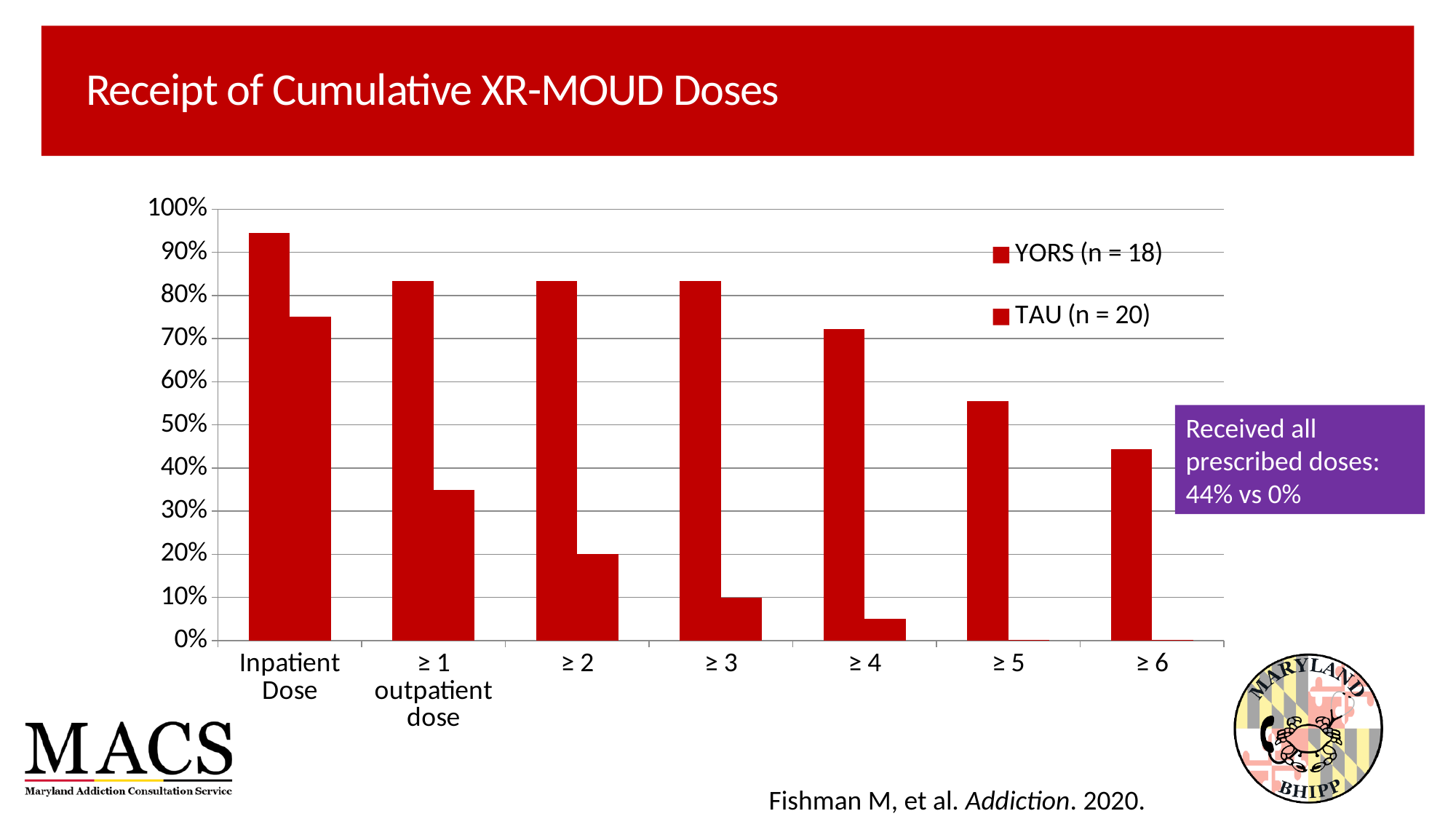
Which category has the lowest YORS (n = 18) value? ≥ 6 For the ≥ 4 category, which series has the larger value, YORS (n = 18) or TAU (n = 20)? YORS (n = 18) How many categories are shown along the x axis? 7 Is the YORS (n = 18) value for Inpatient Dose greater or less than 90%? greater Which category has the highest YORS (n = 18) value? Inpatient Dose Is the TAU (n = 20) value for ≥ 1 outpatient dose greater or less than 40%? less Do the TAU (n = 20) values rise or fall moving from Inpatient Dose to ≥ 6? fall What kind of chart is shown on the slide? bar chart What is the title of the slide containing the chart? Receipt of Cumulative XR-MOUD Doses What is the TAU (n = 20) value for the ≥ 3 category? 10% How many series does the legend list? 2 What is the TAU (n = 20) value for the ≥ 2 category? 20%